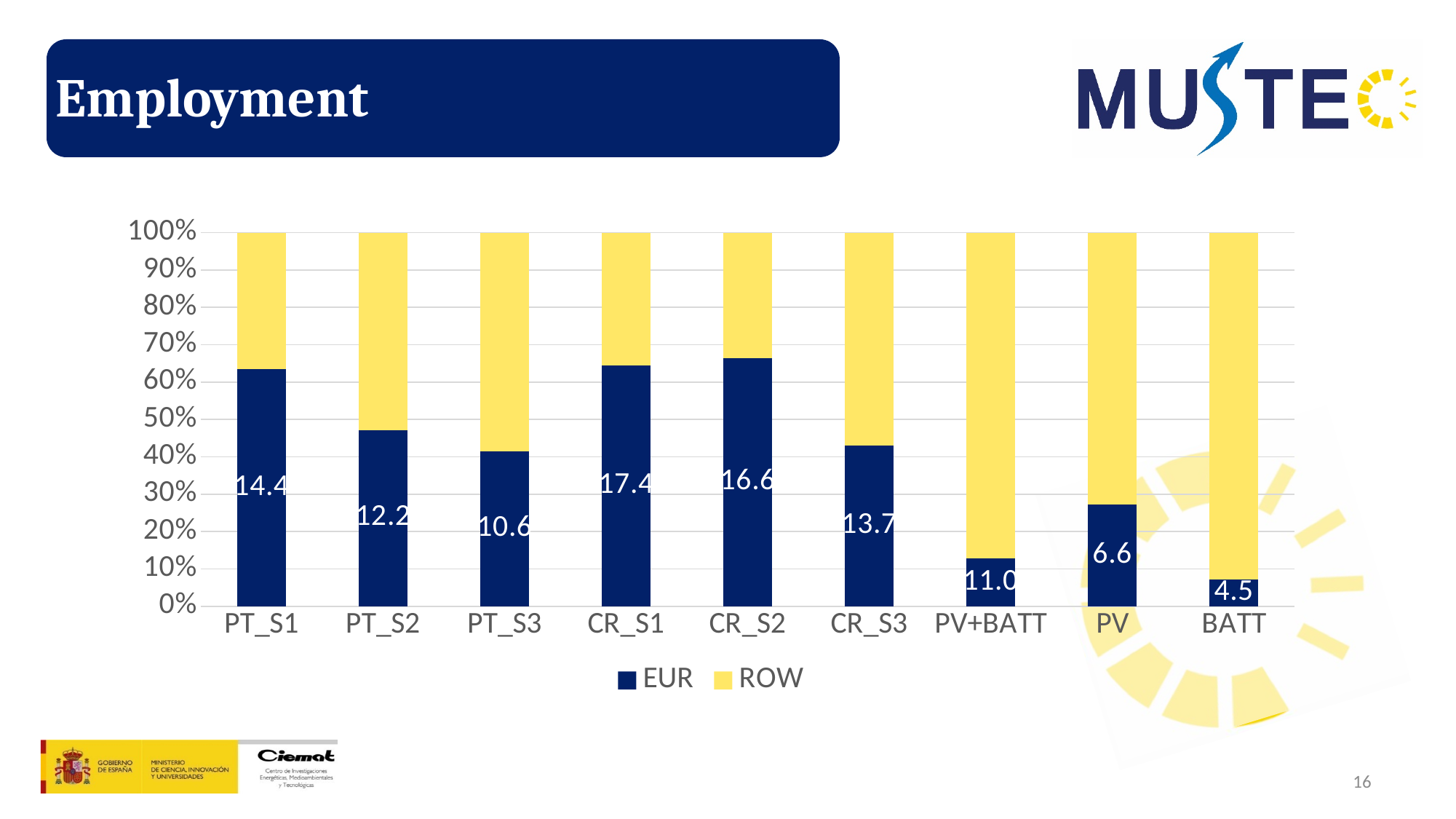
Is the EUR share of the PT_S1 bar greater or less than 50%? greater What is the data label shown on the EUR segment of the CR_S3 bar? 13.7 What is the data label shown on the EUR segment of the PV bar? 6.6 How many series does the legend list? 2 What kind of chart is shown on the slide? Stacked bar chart Which has the larger EUR data label, PT_S2 or PT_S3? PT_S2 Which category has the lowest EUR data label? BATT What is the difference between the EUR data labels for CR_S1 and BATT? 12.9 What is the data label shown on the EUR segment of the PT_S1 bar? 14.4 Is the EUR share of the PV+BATT bar greater or less than 20%? less How many categories are shown on the x axis? 9 Which category has the highest EUR data label? CR_S1